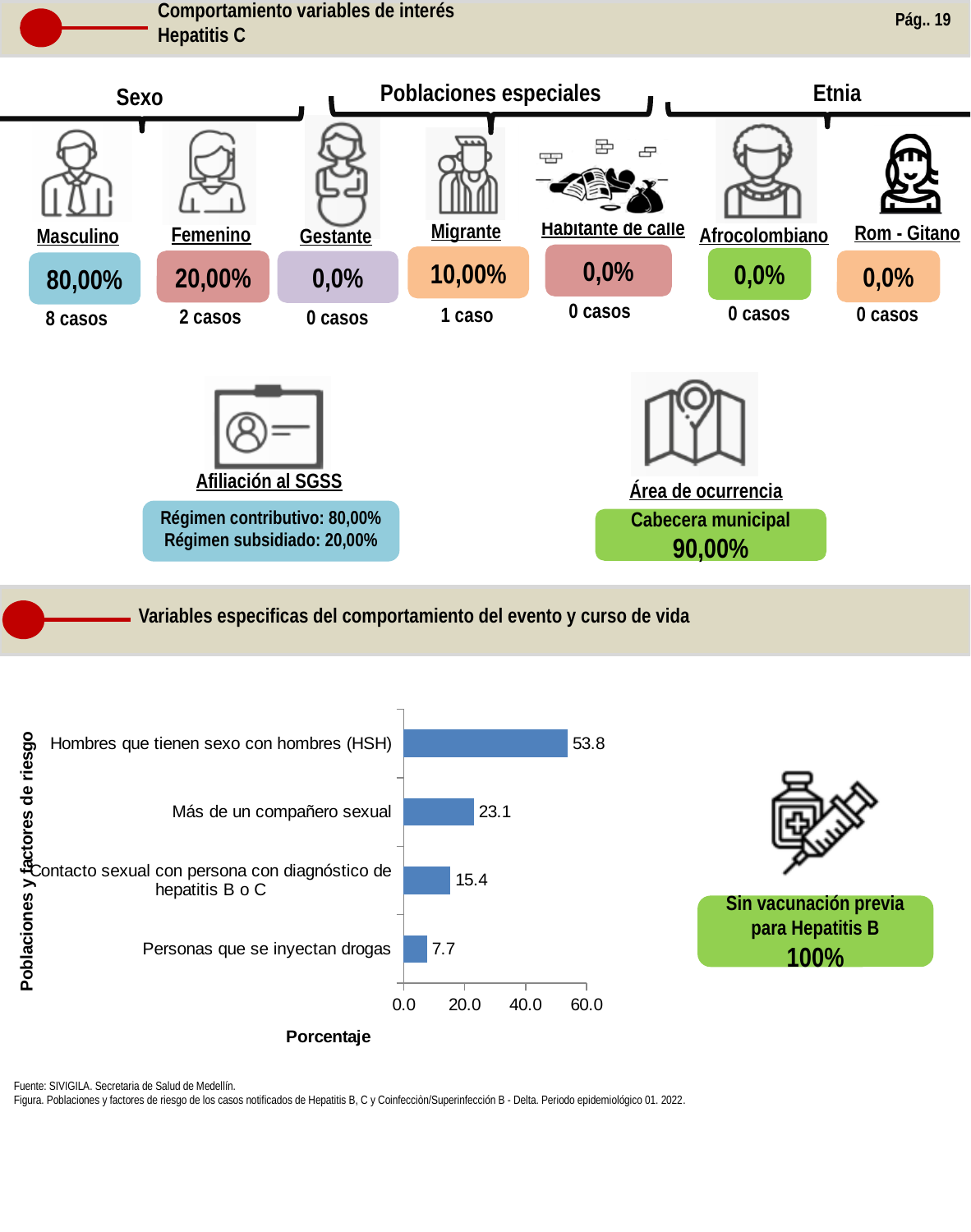
What kind of chart is shown on the slide? bar chart What is the value for Contacto sexual con persona con diagnóstico de hepatitis B o C in the bar chart? 15.4 What is the difference between the values for Hombres que tienen sexo con hombres (HSH) and Más de un compañero sexual in the bar chart? 30.7 Which is larger in the bar chart: Más de un compañero sexual or Contacto sexual con persona con diagnóstico de hepatitis B o C? Más de un compañero sexual What is the value for Hombres que tienen sexo con hombres (HSH) in the bar chart? 53.8 What is the value for Más de un compañero sexual in the bar chart? 23.1 Which category has the lowest value in the bar chart? Personas que se inyectan drogas What is the title of the horizontal axis of the bar chart? Porcentaje Is the value for Hombres que tienen sexo con hombres (HSH) greater or less than 40.0? greater Which category has the highest value in the bar chart? Hombres que tienen sexo con hombres (HSH) How many categories are shown in the bar chart? 4 What is the value for Personas que se inyectan drogas in the bar chart? 7.7